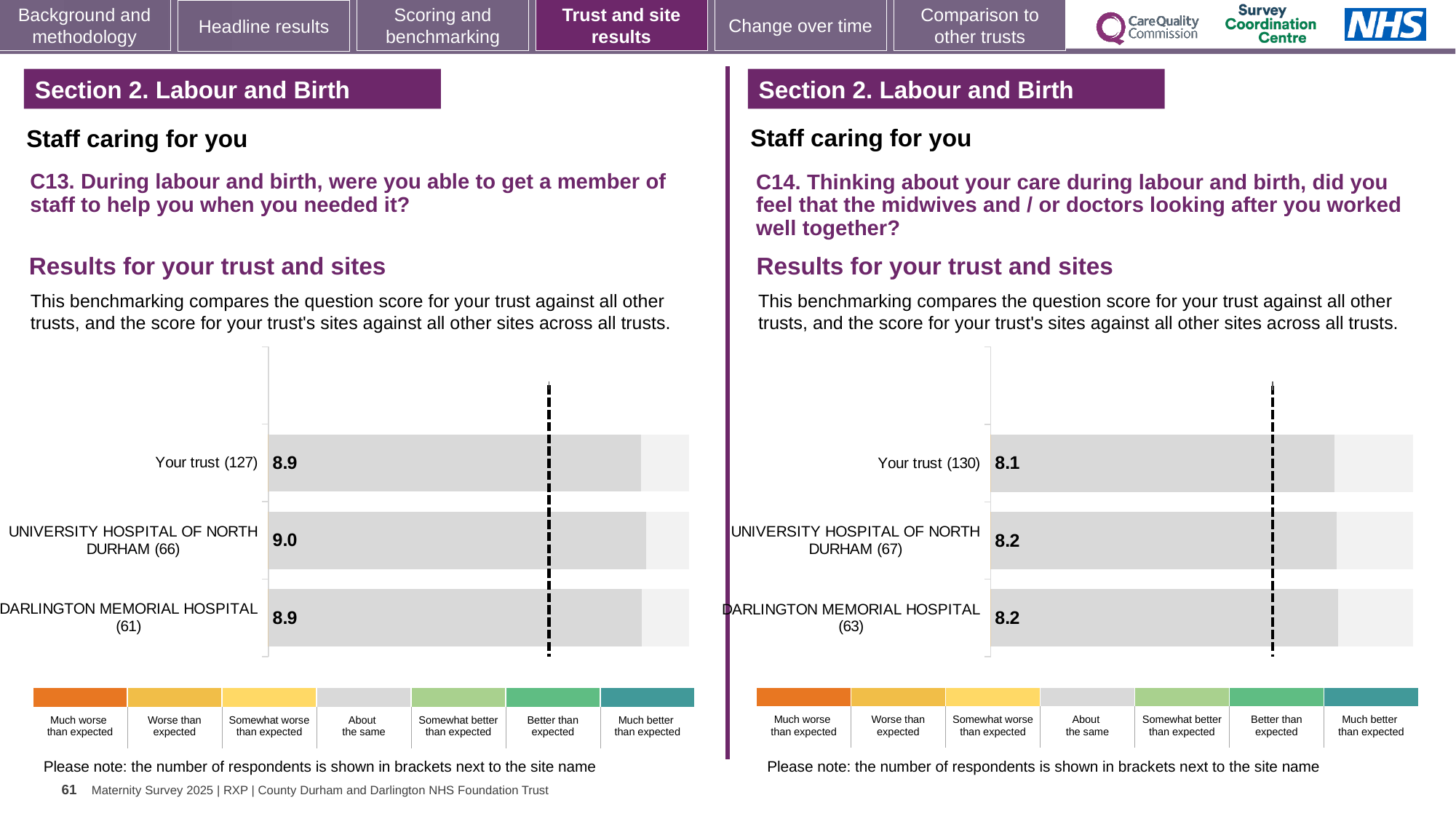
How many rows (trust and sites) are plotted in the C14 chart on the right? 3 In the C13 chart on the left, which row has the highest score? UNIVERSITY HOSPITAL OF NORTH DURHAM (66) In the C14 chart on the right, what is the difference between the score for UNIVERSITY HOSPITAL OF NORTH DURHAM (67) and the score for Your trust (130)? 0.1 In the C13 chart on the left, what is the score for DARLINGTON MEMORIAL HOSPITAL (61)? 8.9 In the C13 chart on the left, which is larger: the score for UNIVERSITY HOSPITAL OF NORTH DURHAM (66) or the score for DARLINGTON MEMORIAL HOSPITAL (61)? UNIVERSITY HOSPITAL OF NORTH DURHAM (66) In the C13 chart on the left, what is the score for UNIVERSITY HOSPITAL OF NORTH DURHAM (66)? 9.0 In the C14 chart on the right, what is the score for Your trust (130)? 8.1 In the C14 chart on the right, what is the score for DARLINGTON MEMORIAL HOSPITAL (63)? 8.2 In the C14 chart on the right, which row has the lowest score? Your trust (130) What kind of chart is used in the C13 chart on the left? Bar chart In the C13 chart on the left, what is the score for Your trust (127)? 8.9 How many respondents are shown in brackets for Your trust in the C13 chart on the left? 127